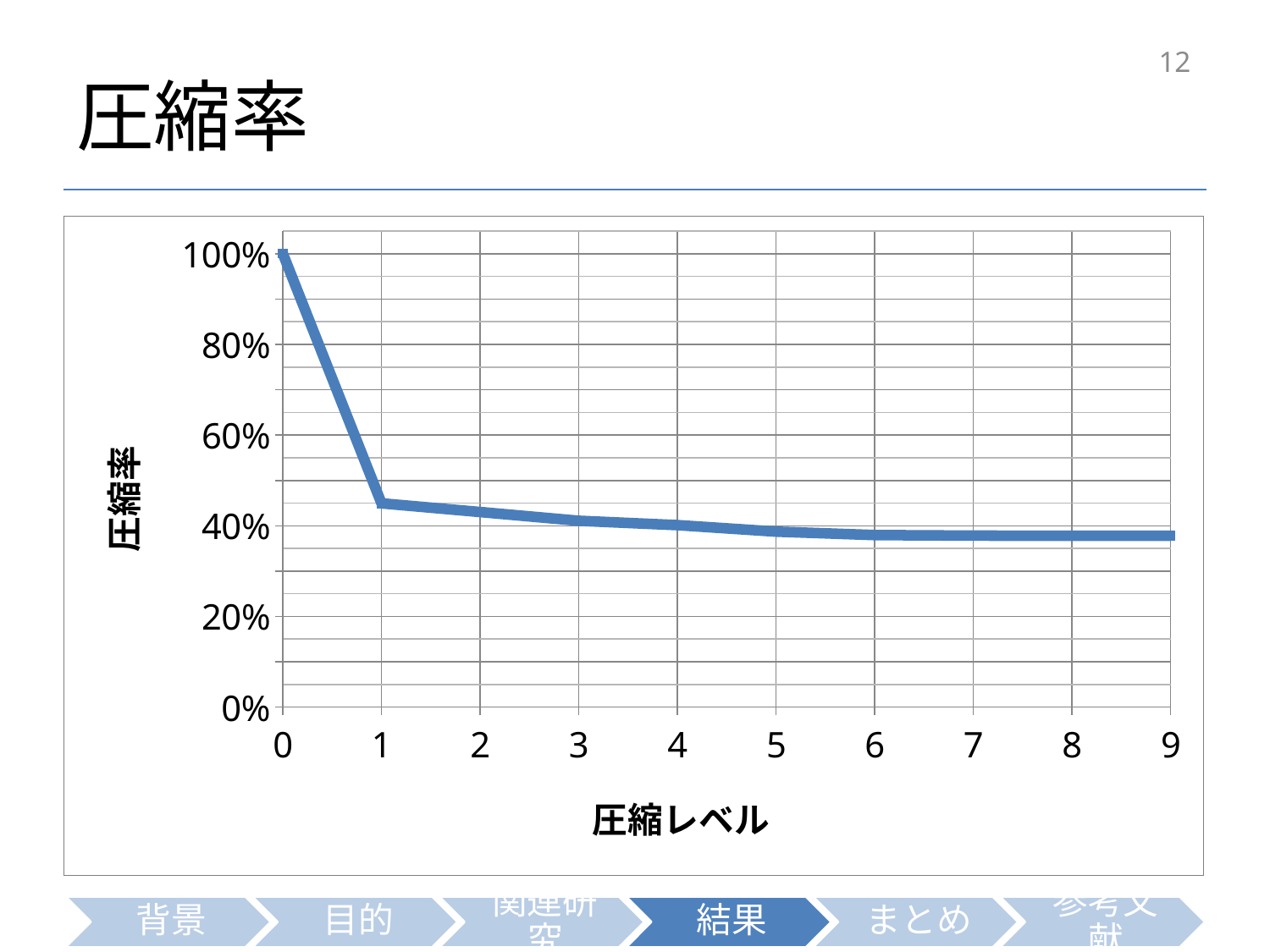
Is the 圧縮率 value at 圧縮レベル 5 greater or less than 20%? greater What is the title of the x axis of the chart? 圧縮レベル Does the 圧縮率 rise or fall as 圧縮レベル increases from 0 to 9? fall Which has a larger 圧縮率 value, 圧縮レベル 1 or 圧縮レベル 9? 圧縮レベル 1 What kind of chart is shown on the slide? line chart At which 圧縮レベル is the 圧縮率 highest? 0 Is the 圧縮率 value at 圧縮レベル 1 greater or less than 40%? greater How many 圧縮レベル points are plotted on the x axis? 10 Is the 圧縮率 value at 圧縮レベル 9 greater or less than 60%? less Which has a larger 圧縮率 value, 圧縮レベル 0 or 圧縮レベル 1? 圧縮レベル 0 What is the 圧縮率 value at 圧縮レベル 0? 100%